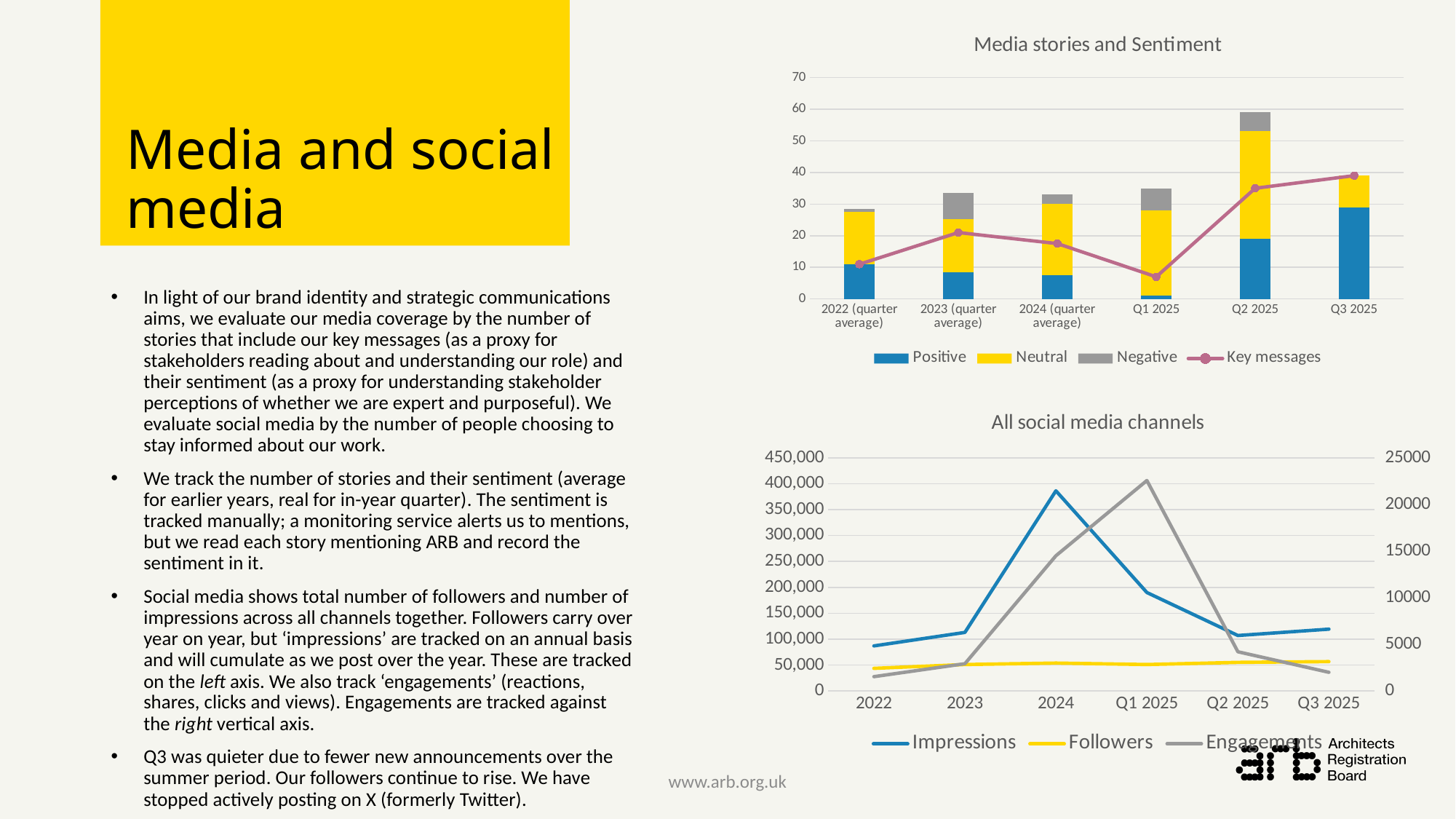
In the 'Media stories and Sentiment' chart, which category has the largest Positive segment? Q3 2025 In the 'All social media channels' chart, in which category do Engagements peak? Q1 2025 In the 'All social media channels' chart, are Impressions for 2024 greater or less than 350,000? greater In the 'Media stories and Sentiment' chart, which category has the tallest stacked bar? Q2 2025 In the 'All social media channels' chart, how many series does the legend list? 3 In the 'Media stories and Sentiment' chart, is the Positive value for Q3 2025 greater or less than 20? greater In the 'Media stories and Sentiment' chart, is the total stacked bar for Q2 2025 greater or less than 50? greater In the 'Media stories and Sentiment' chart, how many categories are shown on the x axis? 6 In the 'Media stories and Sentiment' chart, at which category is the Key messages line lowest? Q1 2025 In the 'All social media channels' chart, which is larger: Engagements in Q1 2025 or Engagements in Q2 2025? Q1 2025 In the 'Media stories and Sentiment' chart, how many series does the legend list? 4